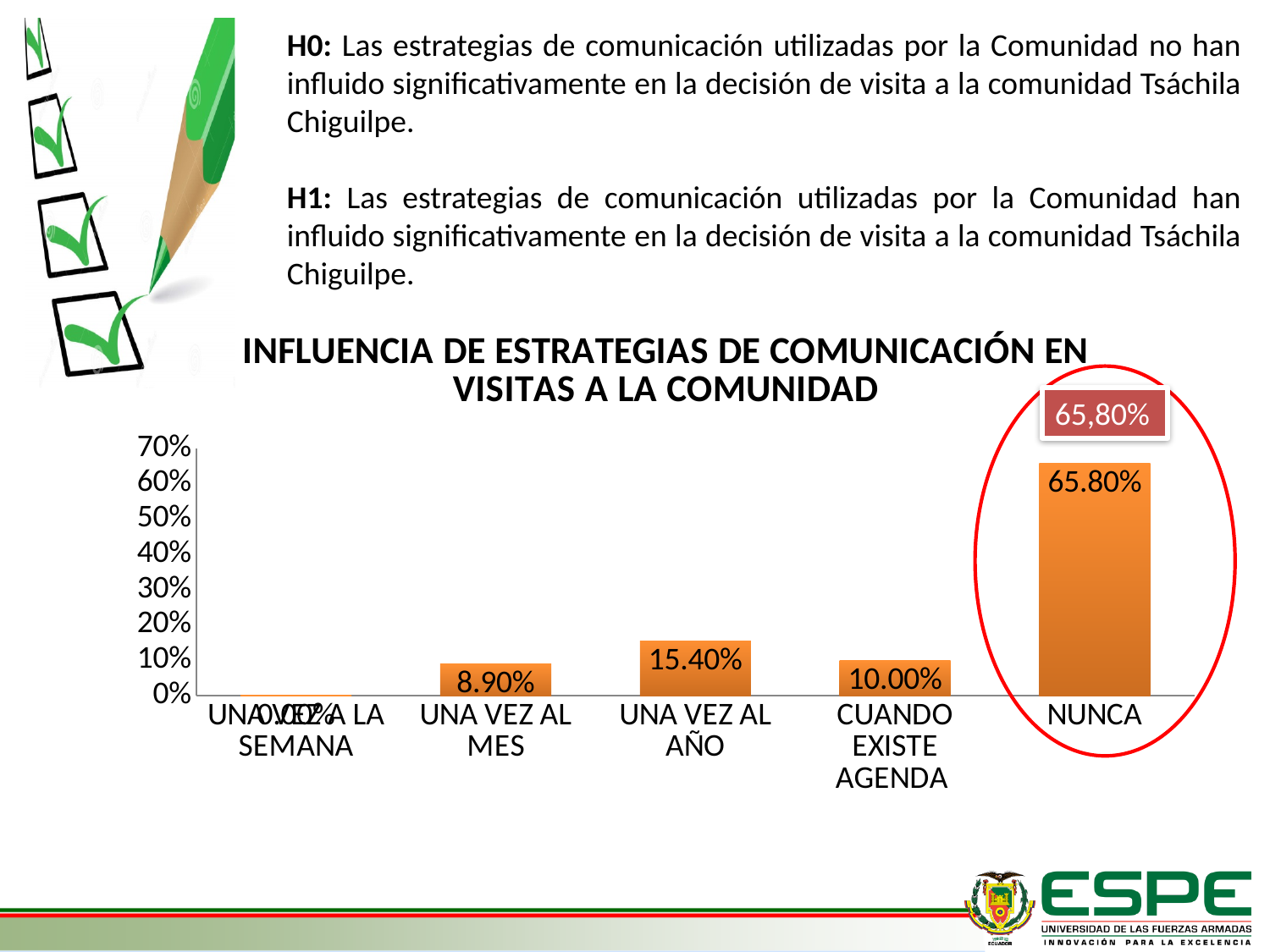
Which category has the highest value? NUNCA Is the value for NUNCA greater or less than 60%? greater What is the value for CUANDO EXISTE AGENDA? 10.00% What is the difference between the values for NUNCA and UNA VEZ AL AÑO? 50.40% Which is larger, the value for CUANDO EXISTE AGENDA or the value for UNA VEZ AL MES? CUANDO EXISTE AGENDA What is the value for UNA VEZ AL MES? 8.90% What is the title of the chart? INFLUENCIA DE ESTRATEGIAS DE COMUNICACIÓN EN VISITAS A LA COMUNIDAD What is the value for NUNCA? 65.80% What kind of chart is shown on the slide? bar chart How many categories are shown on the x axis? 5 What is the difference between the values for UNA VEZ AL AÑO and UNA VEZ AL MES? 6.50% What is the value for UNA VEZ AL AÑO? 15.40%